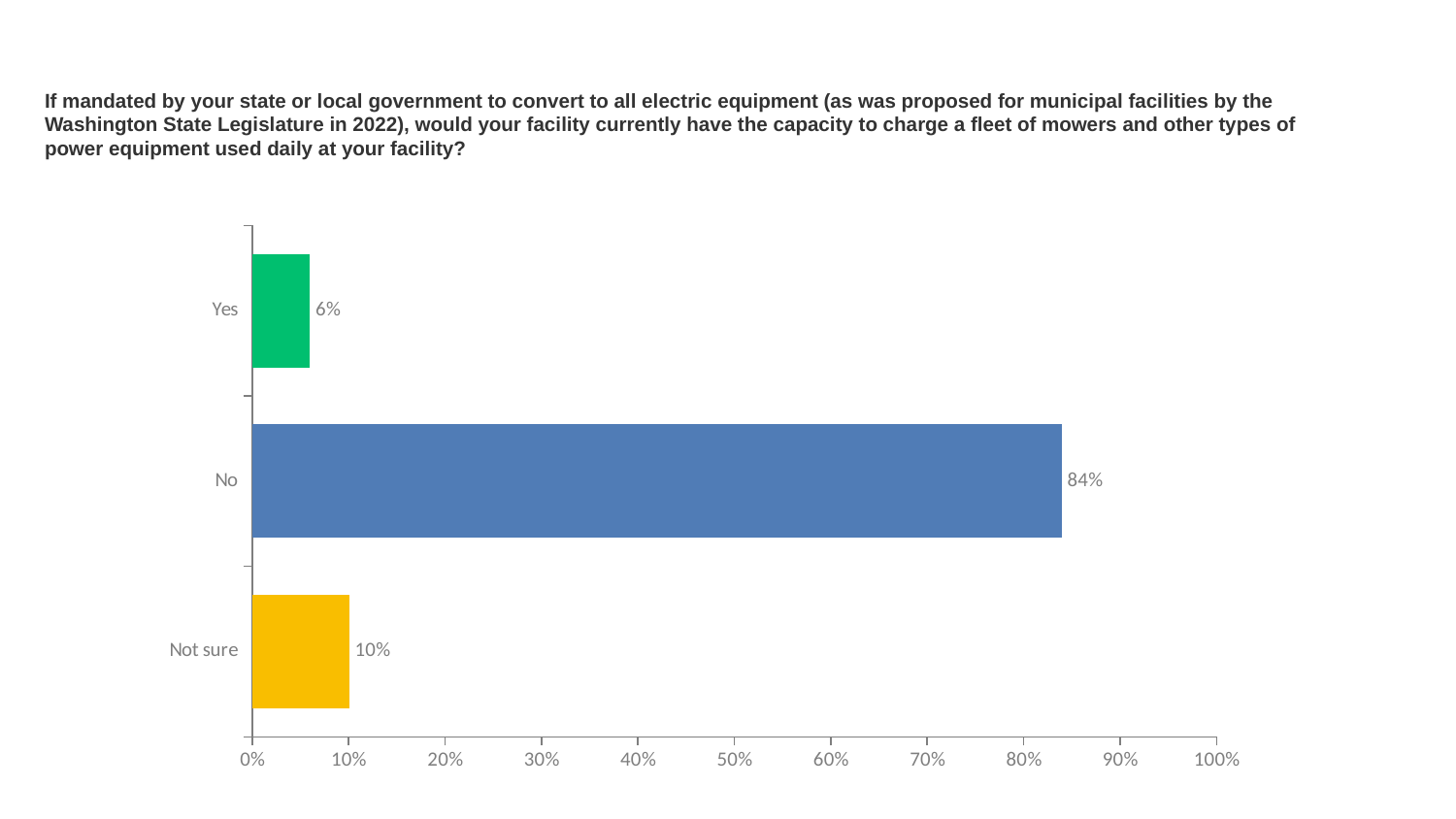
Is the value for "No" greater or less than 80%? greater What percentage of respondents answered "Not sure"? 10% What percentage of respondents answered "No"? 84% How many response categories are shown in the chart? 3 What is the difference in percentage points between the "Not sure" and "Yes" responses? 4 Which response category has the lowest percentage? Yes Which is larger, the percentage for "Not sure" or the percentage for "Yes"? Not sure What colour is the bar for the "No" response? Blue What type of chart is shown on the slide? Bar chart Which response category has the highest percentage? No What is the difference in percentage points between the "No" and "Not sure" responses? 74 What percentage of respondents answered "Yes"? 6%